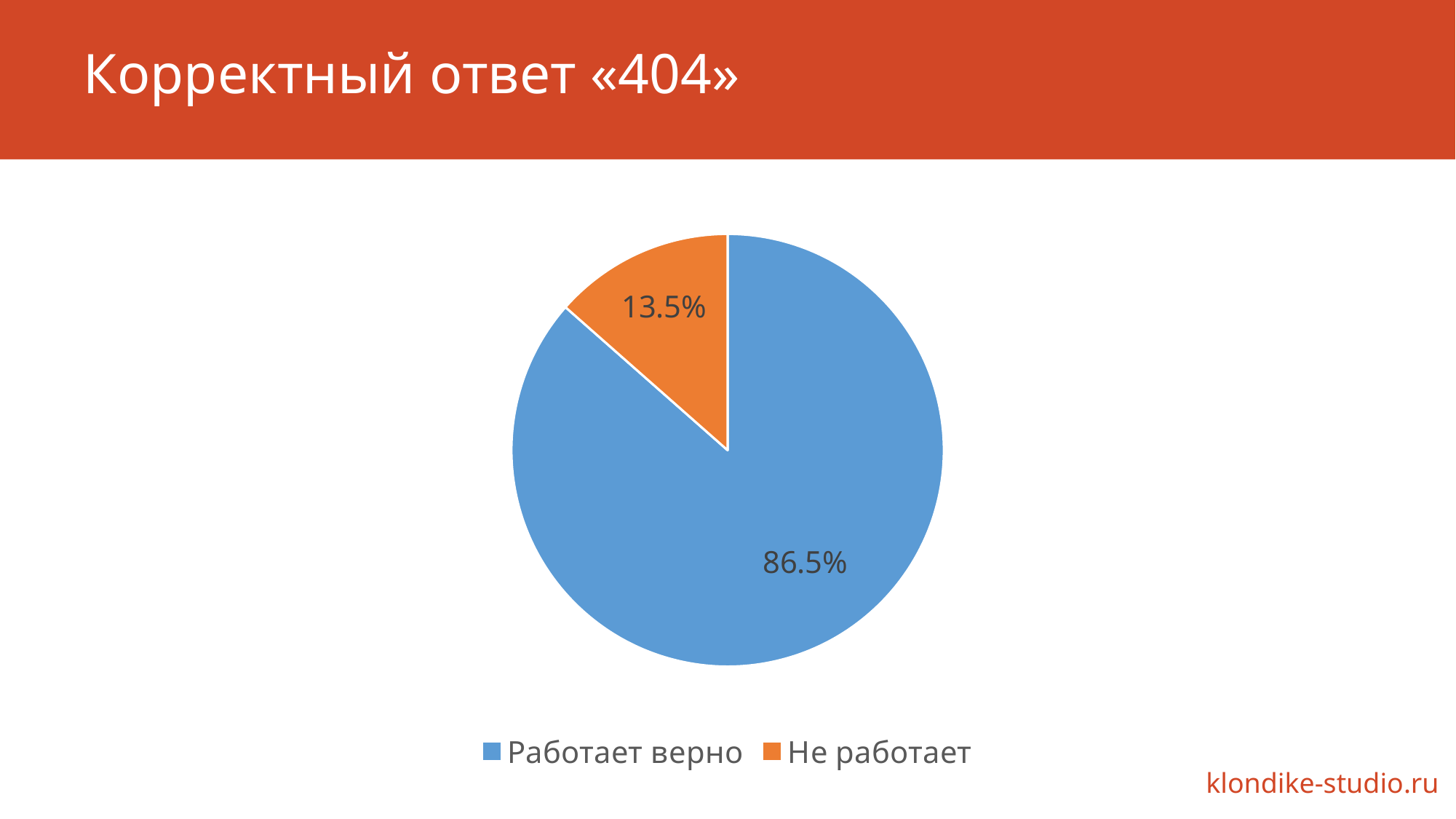
What is the title of the slide containing the chart? Корректный ответ «404» Which is larger, «Работает верно» or «Не работает»? Работает верно What is the difference between the «Работает верно» and «Не работает» slices? 73.0% What kind of chart is shown on the slide? pie chart How many entries does the legend list? 2 What is the value for «Работает верно»? 86.5% Which category has the smallest slice? Не работает What share of the pie does «Не работает» take? 13.5% What is the value for «Не работает»? 13.5% Which category has the largest slice? Работает верно What colour is the «Не работает» slice? orange How many slices does the pie chart have? 2